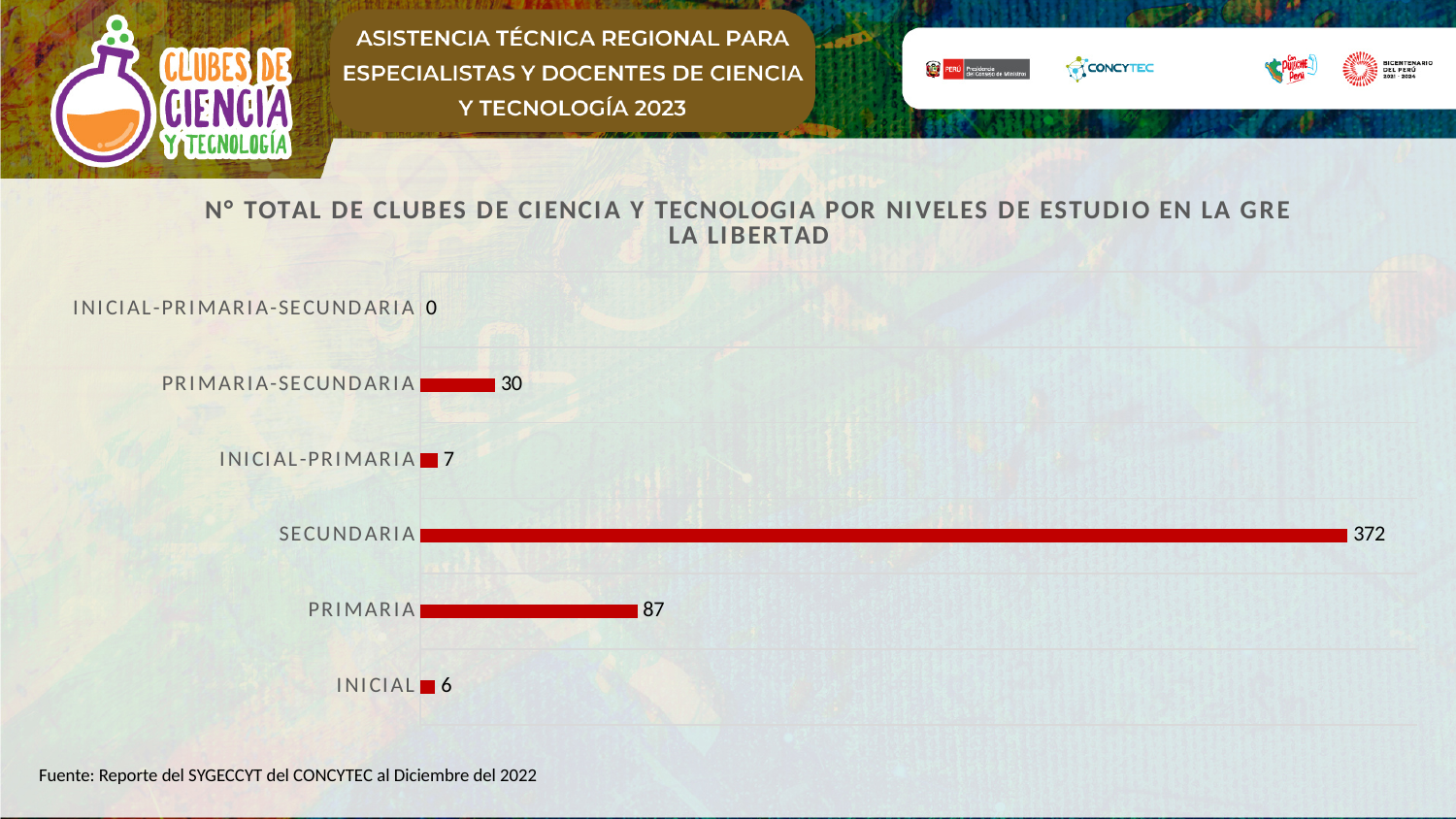
What is the value for PRIMARIA? 87 How many clubs are shown for SECUNDARIA? 372 What kind of chart is shown on the slide? Bar chart What is the difference between the values for PRIMARIA-SECUNDARIA and INICIAL? 24 What is the source cited below the chart? Reporte del SYGECCYT del CONCYTEC al Diciembre del 2022 Which is larger, the value for INICIAL-PRIMARIA or the value for INICIAL? INICIAL-PRIMARIA How many categories (levels) are shown in the chart? 6 What is the value for INICIAL-PRIMARIA? 7 Which level has the highest number of clubs? SECUNDARIA What is the value for INICIAL-PRIMARIA-SECUNDARIA? 0 What is the difference between the values for SECUNDARIA and PRIMARIA? 285 Which level has the lowest number of clubs? INICIAL-PRIMARIA-SECUNDARIA